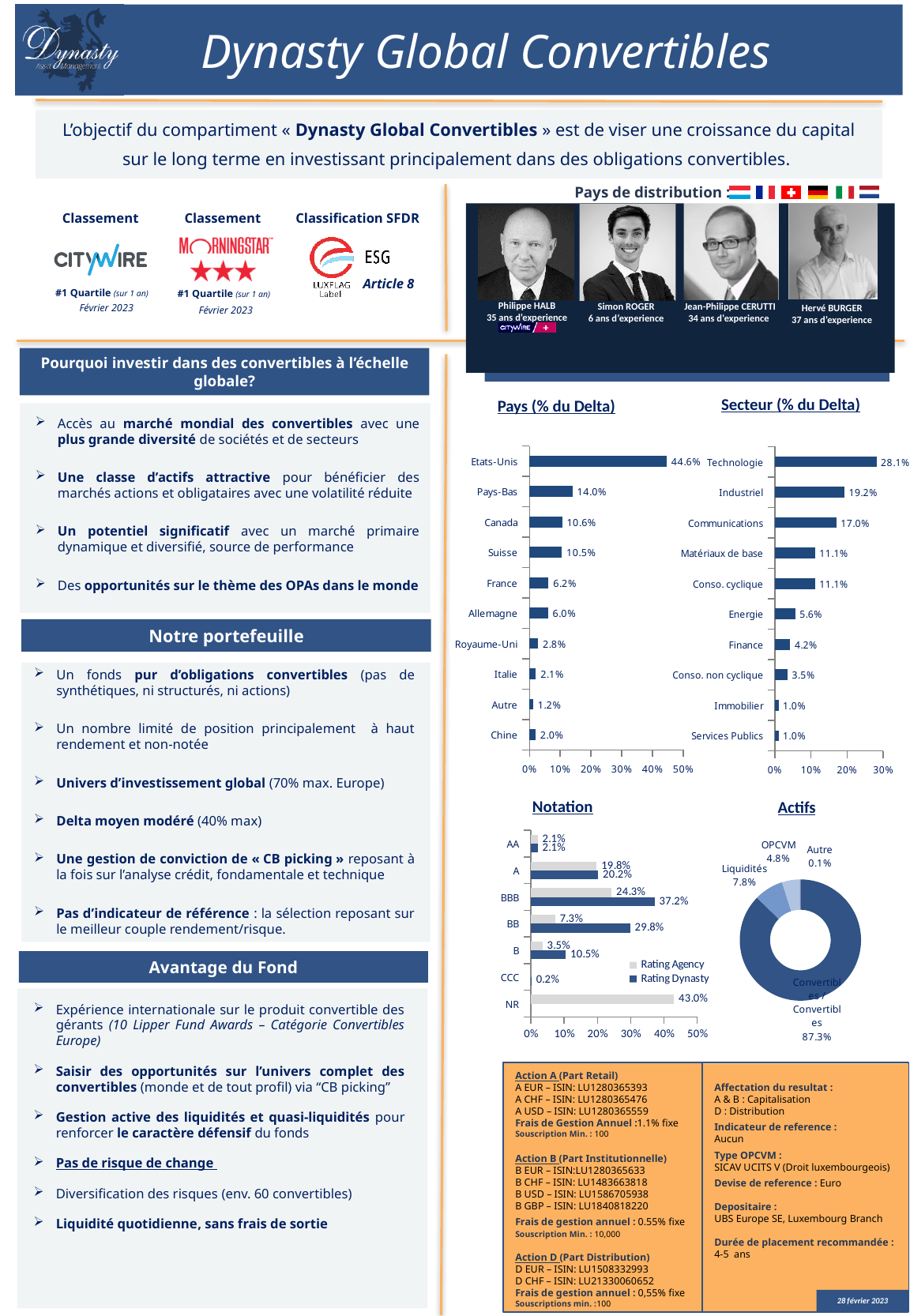
In the 'Notation' chart, how many series does the legend list? 2 In the 'Pays (% du Delta)' chart, what is the value for Etats-Unis? 44.6% In the 'Secteur (% du Delta)' chart, what is the value for Communications? 17.0% In the 'Secteur (% du Delta)' chart, which is larger, Energie or Finance? Energie In the 'Secteur (% du Delta)' chart, what is the difference between Technologie and Industriel? 8.9% In the 'Notation' chart, what is the Rating Dynasty value for BBB? 37.2% In the 'Notation' chart, what is the Rating Agency value for NR? 43.0% What kind of chart is the 'Actifs' chart? Doughnut chart In the 'Secteur (% du Delta)' chart, which sector has the highest value? Technologie In the 'Pays (% du Delta)' chart, how many categories are shown? 10 In the 'Pays (% du Delta)' chart, which country has the lowest value? Autre In the 'Pays (% du Delta)' chart, what is the difference between Pays-Bas and Canada? 3.4%